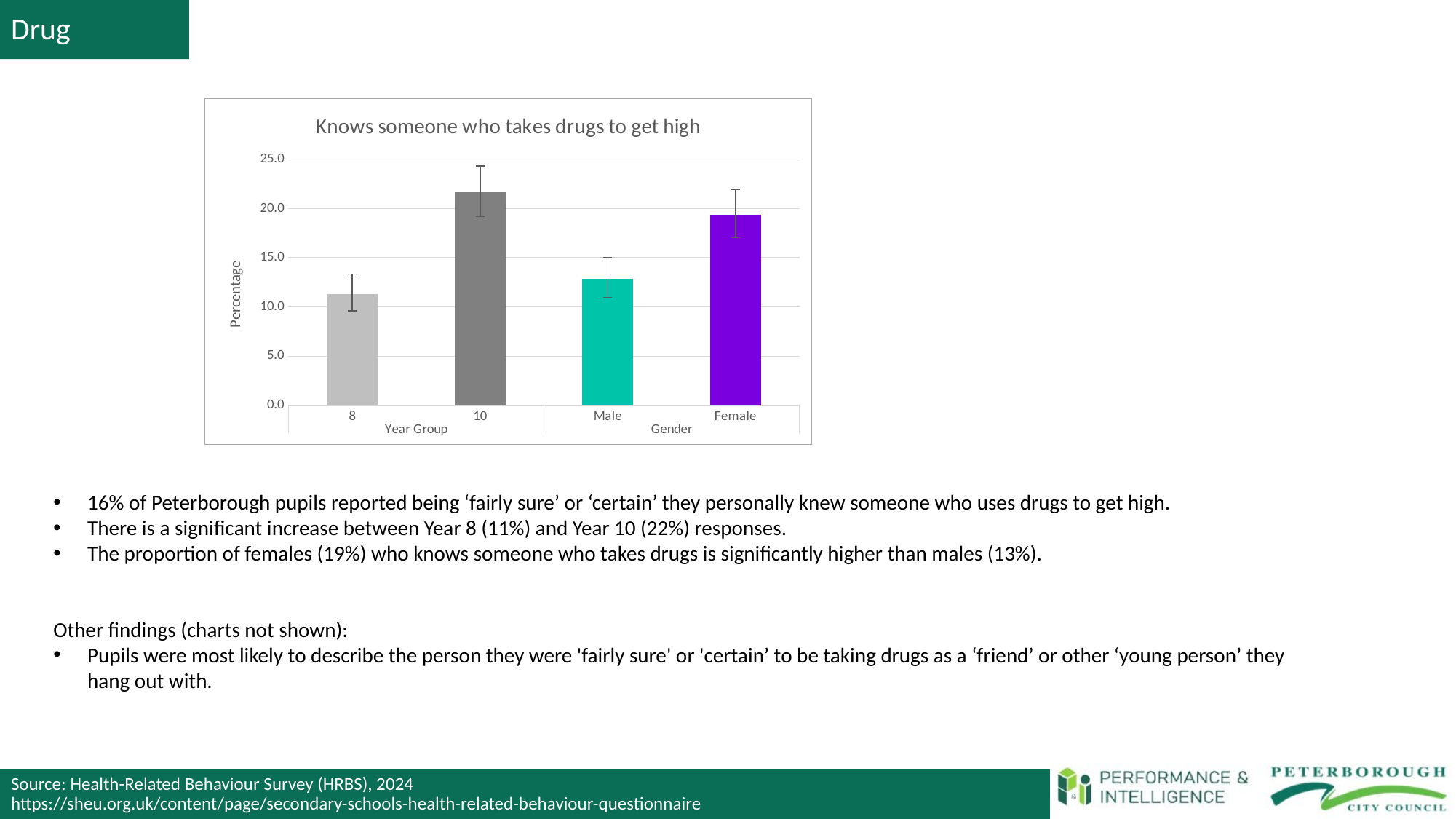
Which is larger, the bar for Year 10 or the bar for Female? Year 10 Is the value for Female greater or less than 15.0? greater Is the value for Male greater or less than 10.0? greater Is the value for Year 10 greater or less than 20.0? greater Which category has the highest bar in the chart? 10 (Year Group) How many bars are plotted in the chart? 4 What kind of chart is shown on the slide? Bar chart Which category has the lowest bar in the chart? 8 (Year Group) What is the label on the vertical axis of the chart? Percentage What is the title of the chart? Knows someone who takes drugs to get high Is the bar for Female higher or lower than the bar for Male? Higher